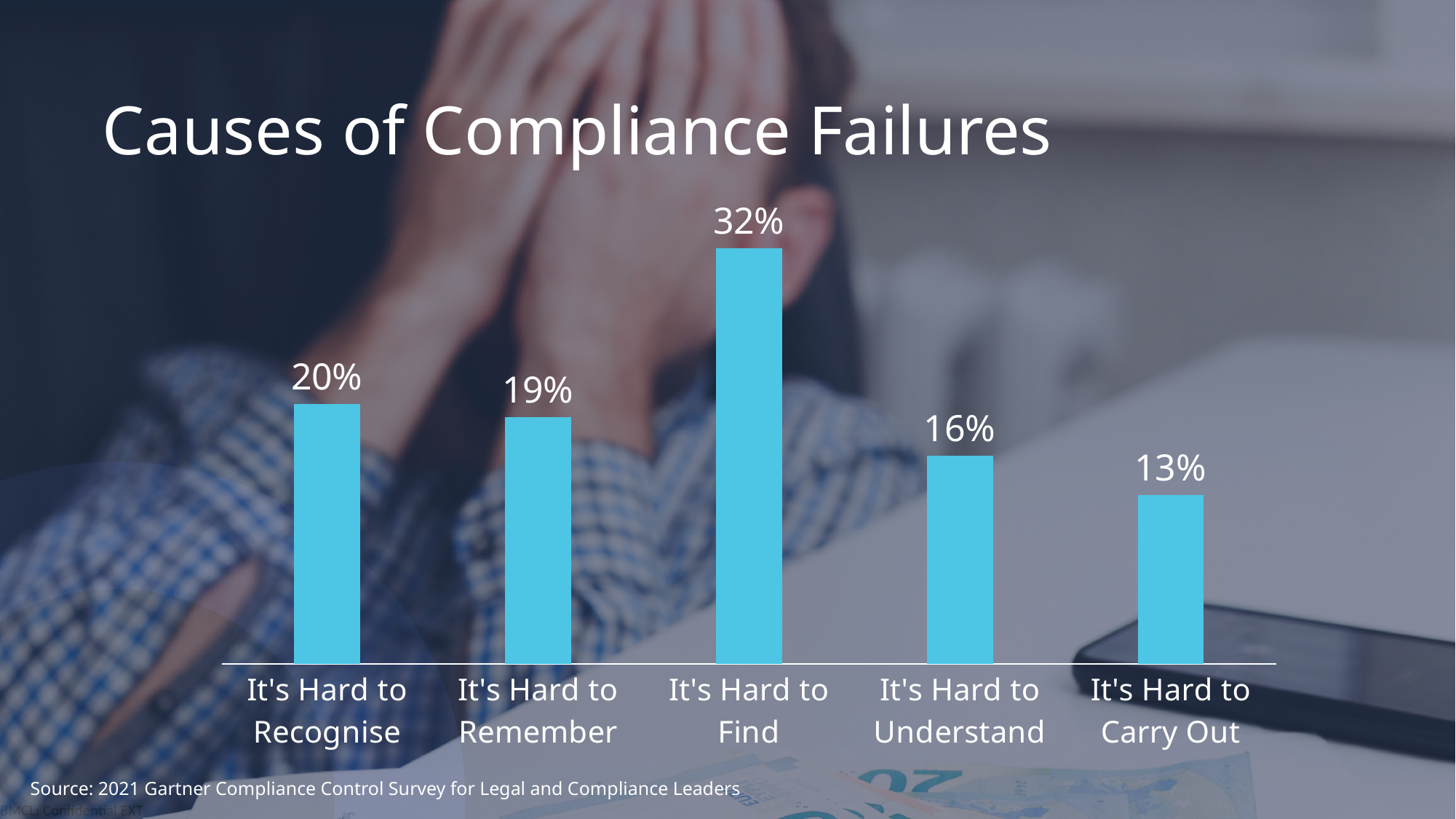
What is the title of the slide? Causes of Compliance Failures What percentage is shown for "It's Hard to Carry Out"? 13% Which is larger, the percentage for "It's Hard to Recognise" or "It's Hard to Understand"? It's Hard to Recognise What percentage is shown for "It's Hard to Remember"? 19% Which cause of compliance failure has the lowest percentage? It's Hard to Carry Out Which cause of compliance failure has the highest percentage? It's Hard to Find What kind of chart is shown on the slide? Bar chart How many causes of compliance failure are shown in the chart? 5 What is the difference between the percentages for "It's Hard to Recognise" and "It's Hard to Carry Out"? 7% What is the difference between the percentages for "It's Hard to Find" and "It's Hard to Understand"? 16% What percentage is shown for "It's Hard to Find"? 32% What is the source cited for the chart data? 2021 Gartner Compliance Control Survey for Legal and Compliance Leaders